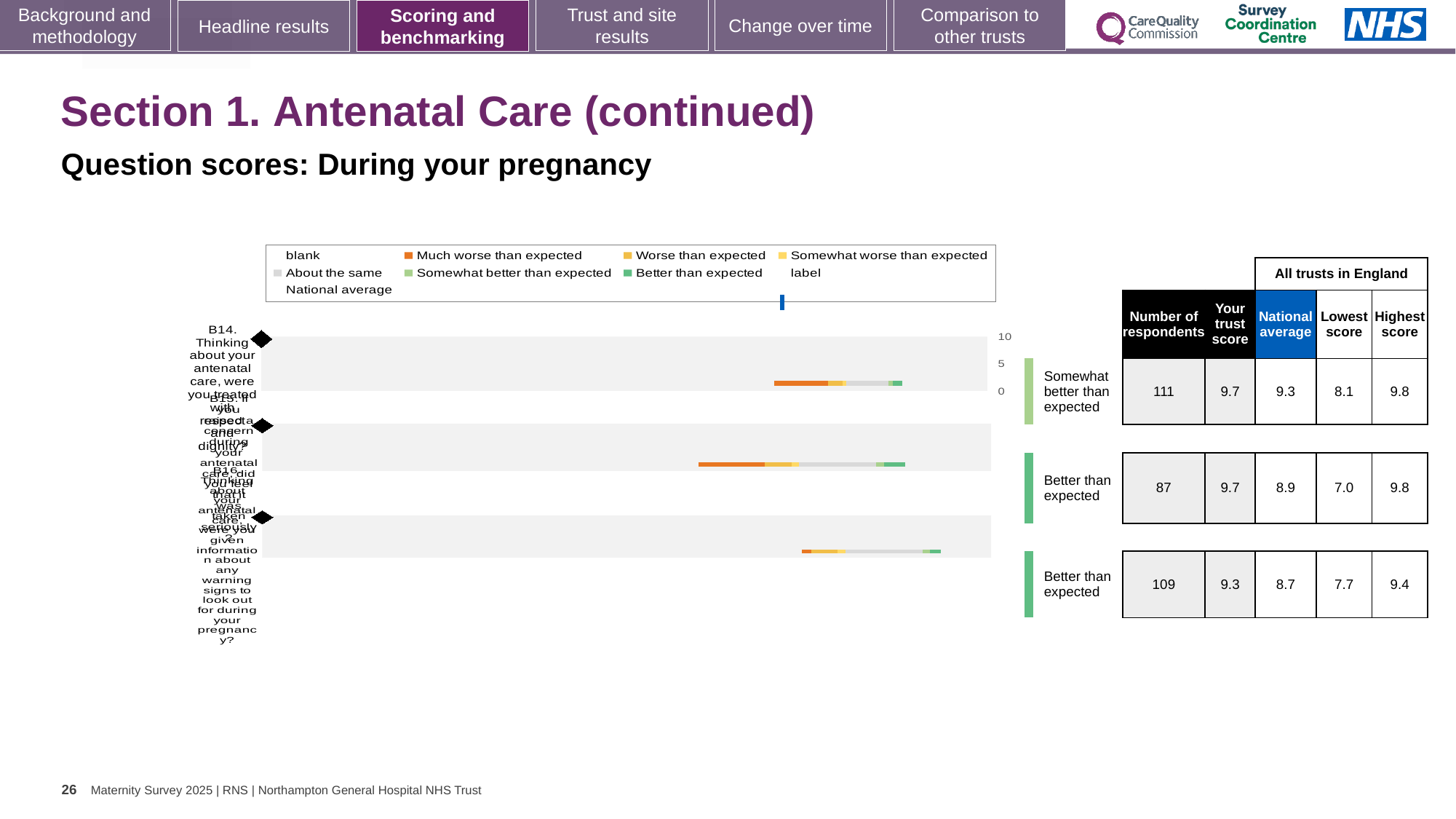
What is the number of respondents for question B14 (treated with respect and dignity)? 111 What is the trust score for question B16 (information about warning signs during pregnancy)? 9.3 Which legend entry is shown in orange? Much worse than expected What kind of chart is shown on the slide? bar chart What benchmark category is given for question B14? Somewhat better than expected Which of the three questions has the lowest number of respondents? B15 How many question bars are plotted in the chart? 3 What is the lowest score across all trusts in England for question B15? 7.0 What is the national average for question B15 (concerns taken seriously)? 8.9 What is the difference between the trust score and the national average for question B15? 0.8 What is the highest value shown on the chart's axis? 10 Which is larger for question B16: the trust score or the national average? trust score